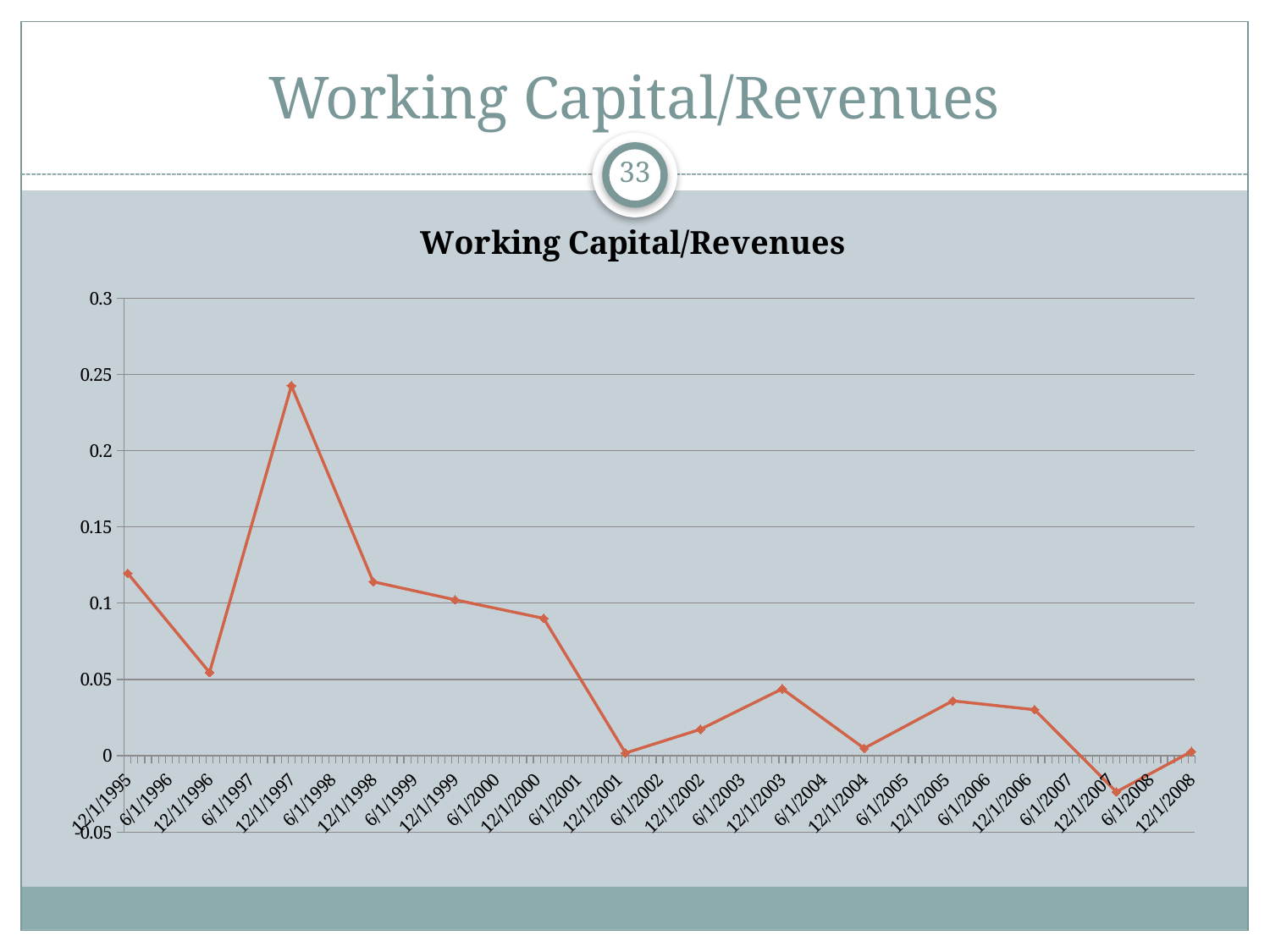
Is the value for 12/1/1997 greater or less than 0.2? greater Which is larger, the value for 12/1/2003 or the value for 12/1/2004? 12/1/2003 Is the value for 12/1/1995 greater or less than 0.1? greater What kind of chart is shown on the slide? line chart Is the value for 12/1/2005 greater or less than 0.05? less Overall, does the Working Capital/Revenues line rise or fall from 12/1/1995 to 12/1/2008? fall What is the title of the chart? Working Capital/Revenues Which is larger, the value for 12/1/1995 or the value for 12/1/1996? 12/1/1995 At which date does the Working Capital/Revenues line reach its lowest value? 12/1/2007 At which date does the Working Capital/Revenues line reach its highest value? 12/1/1997